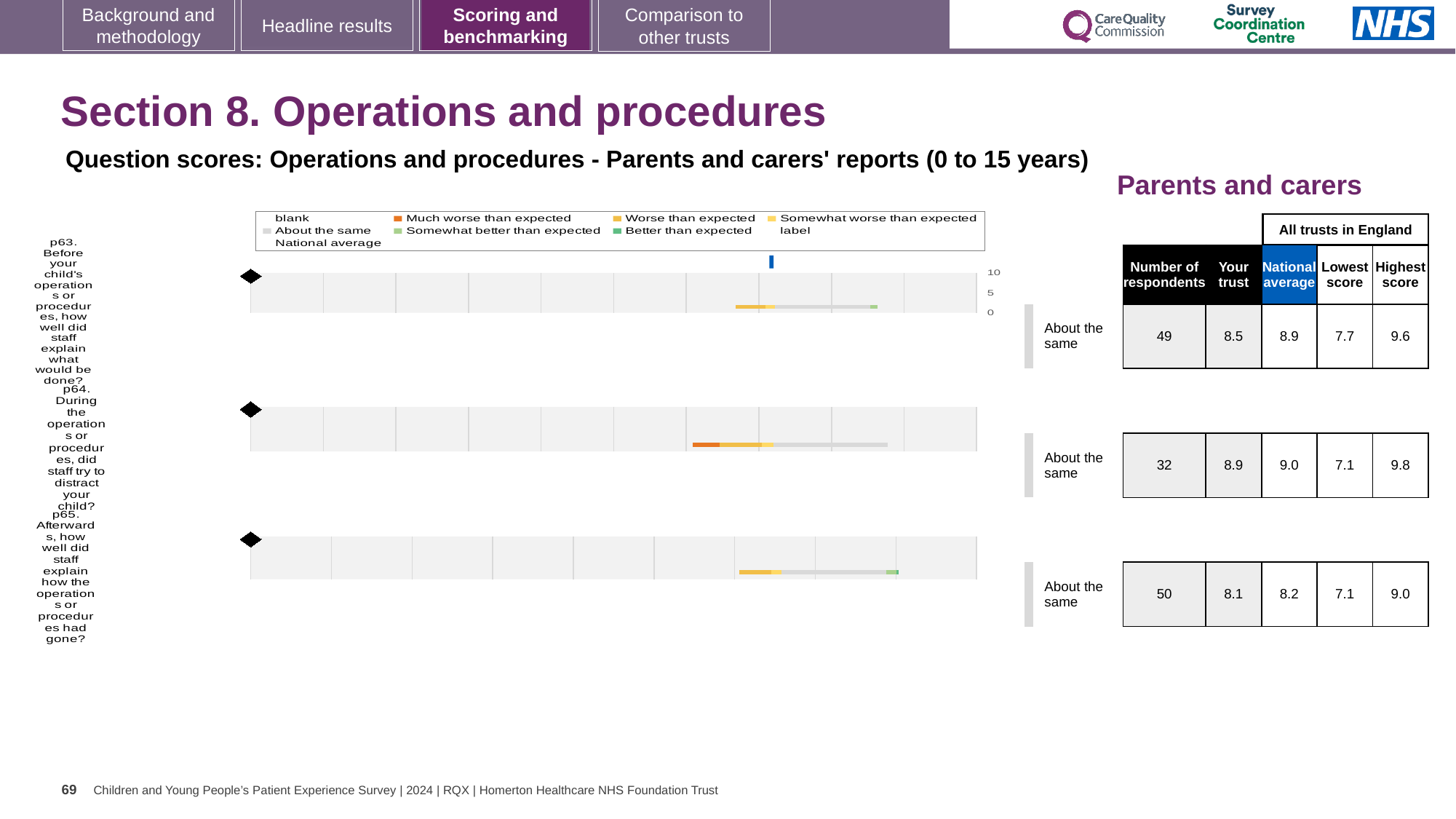
Which of the three questions has the highest 'Your trust' score? p64 What benchmark category is shown for each of the three questions? About the same Is the 'Your trust' score for question p65 greater or less than 5? greater What is the 'Your trust' score for question p63 (Before your child's operations or procedures, how well did staff explain what would be done?)? 8.5 What is the national average score for question p64 (During the operations or procedures, did staff try to distract your child?)? 9.0 Which is larger: the 'Your trust' score for p63 or for p64? p64 What is the difference between the national average and the 'Your trust' score for question p63? 0.4 How many questions are plotted on the slide? 3 How many respondents answered question p65 (Afterwards, how well did staff explain how the operations or procedures had gone?)? 50 What is the highest score across all trusts in England for question p64? 9.8 What is the lowest score across all trusts in England for question p65? 7.1 Which of the three questions has the lowest 'Your trust' score? p65